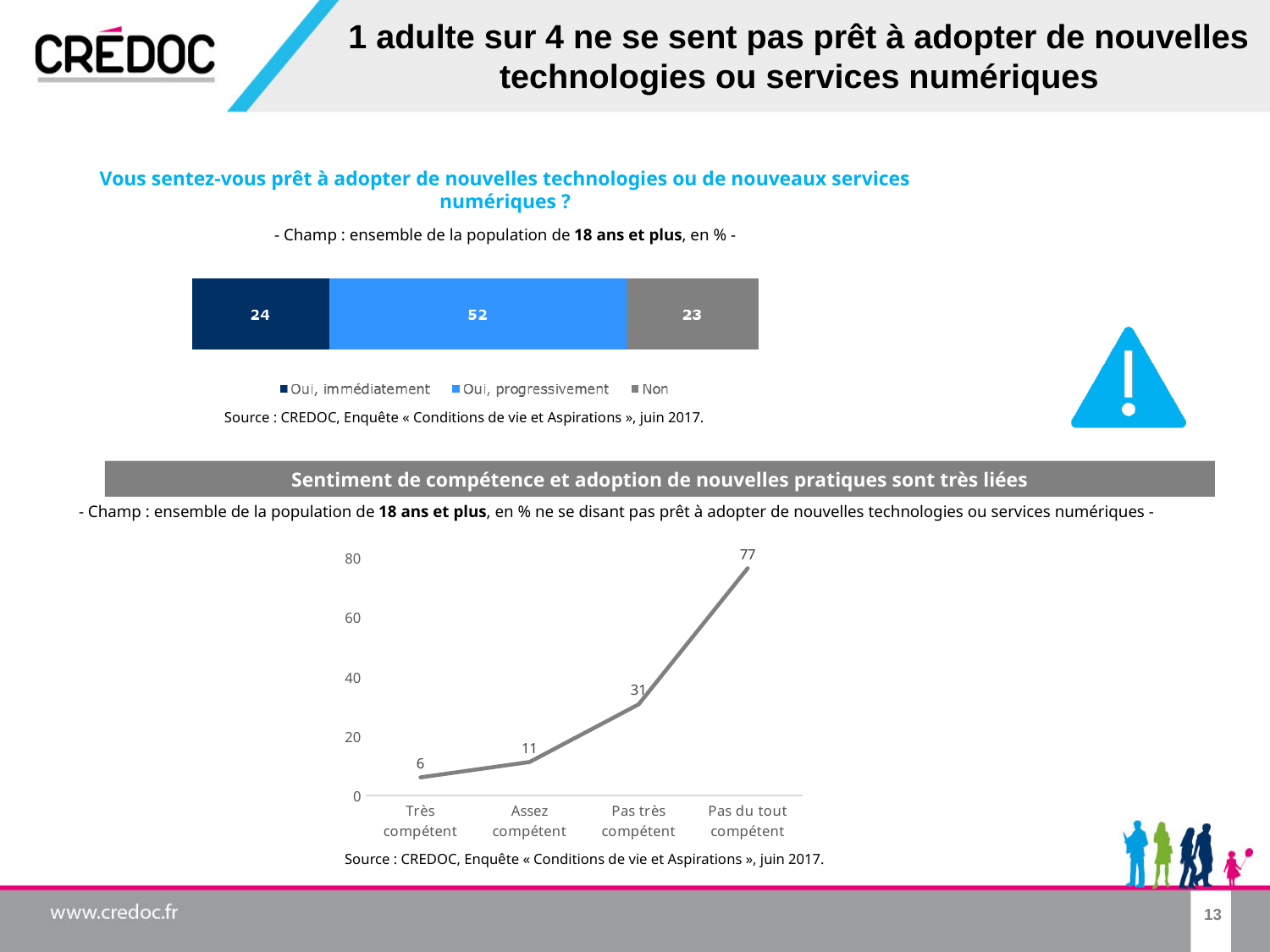
In the bottom line chart, what is the value for "Assez compétent"? 11 In the top stacked bar chart, what is the difference between "Oui, immédiatement" and "Non"? 1 In the top stacked bar chart, what is the value for "Non"? 23 In the top stacked bar chart, how many series does the legend list? 3 In the top stacked bar chart, what is the value for "Oui, progressivement"? 52 In the bottom line chart, do the values rise or fall from left to right along the x axis? rise In the bottom line chart, what is the value for "Pas du tout compétent"? 77 In the top stacked bar chart, which segment is the largest? Oui, progressivement In the top stacked bar chart, what is the total of the three segments? 99 What kind of chart is the bottom chart on the slide? line chart In the bottom line chart, which category has the lowest value? Très compétent In the bottom line chart, what is the difference between "Pas du tout compétent" and "Pas très compétent"? 46